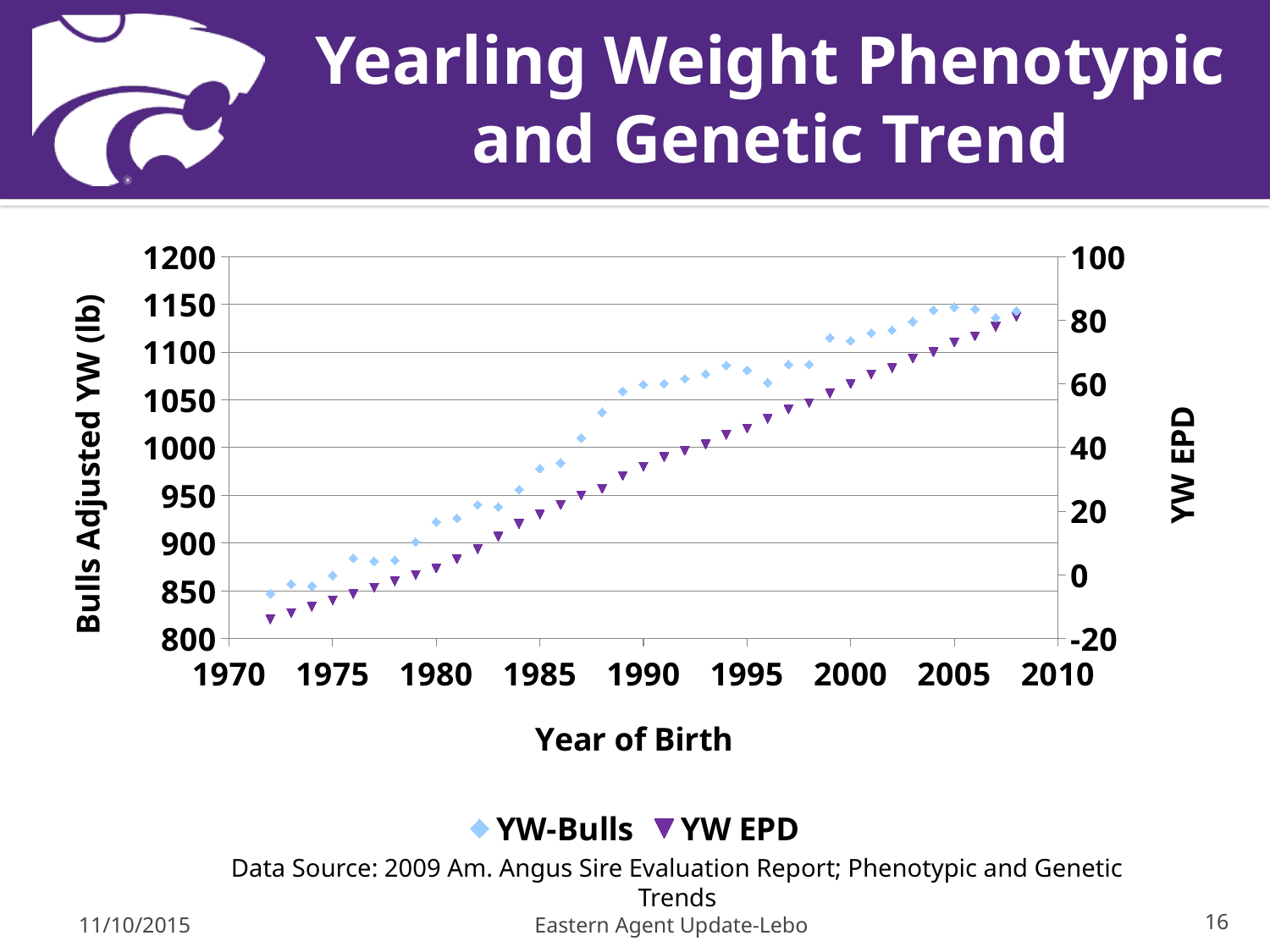
Is the YW-Bulls value for 2005 greater or less than 1100? greater Is the YW EPD value for 2008 greater or less than 60? greater Is the YW EPD value for 1972 greater or less than 0? less Do the YW-Bulls values generally rise or fall as Year of Birth increases? rise How many series does the legend list? 2 What is the title of the x axis? Year of Birth What kind of chart is shown on the slide? scatter chart What are the two series named in the legend? YW-Bulls and YW EPD Do the YW EPD values generally rise or fall as Year of Birth increases? rise